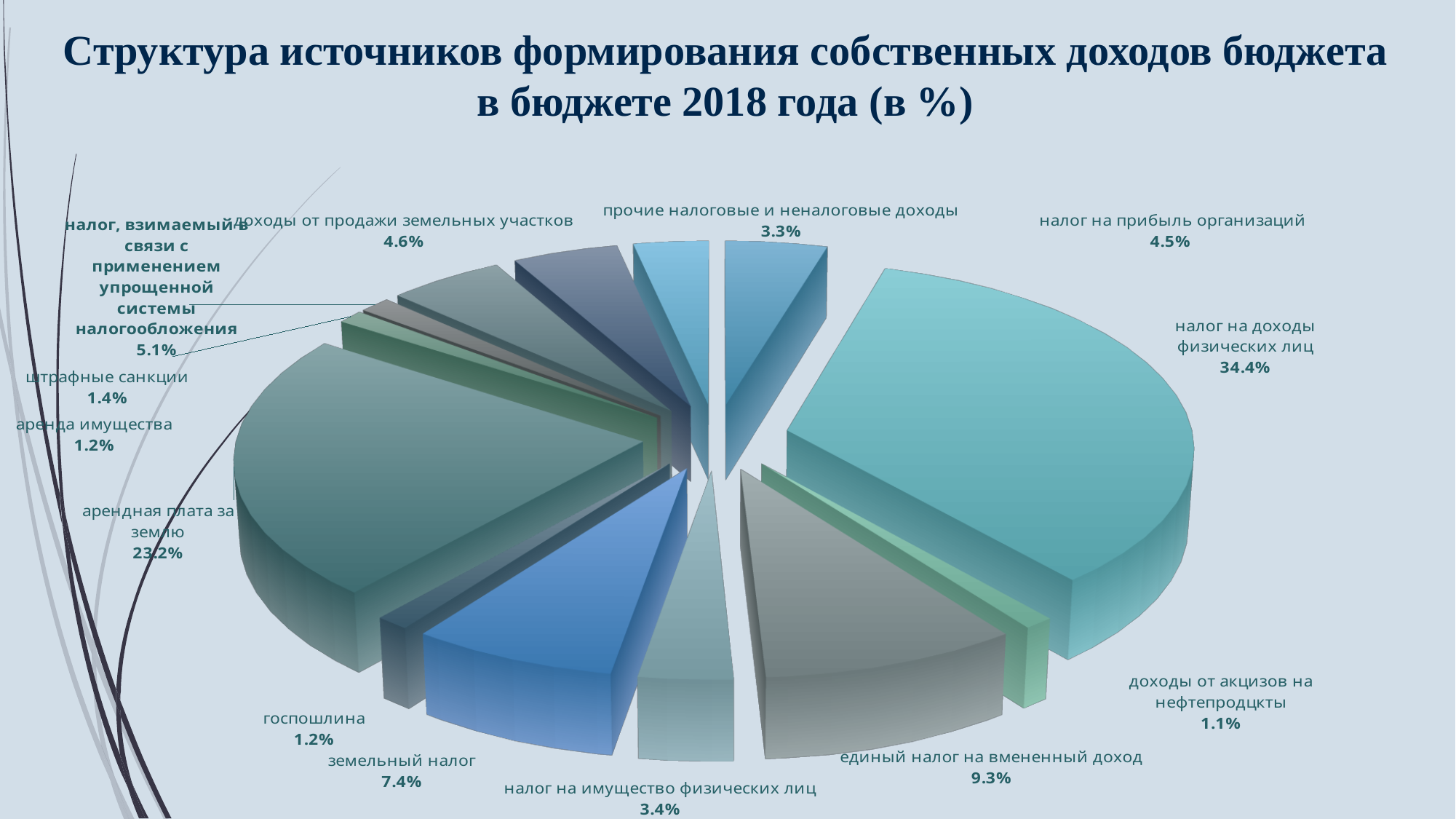
What is the value shown for "земельный налог"? 7.4% What type of chart is shown on the slide? pie chart What is the value shown for "единый налог на вмененный доход"? 9.3% How many categories are shown in the pie chart? 13 What is the title of the chart on the slide? Структура источников формирования собственных доходов бюджета в бюджете 2018 года (в %) What share does "налог на доходы физических лиц" have in the pie chart? 34.4% Which is larger: the share of "земельный налог" or the share of "налог, взимаемый в связи с применением упрощенной системы налогообложения"? земельный налог Which category has the largest share in the pie chart? налог на доходы физических лиц What is the difference between the shares of "налог на доходы физических лиц" and "арендная плата за землю"? 11.2% What is the value shown for "доходы от продажи земельных участков"? 4.6% What share does "арендная плата за землю" have in the pie chart? 23.2% Which category has the smallest share in the pie chart? доходы от акцизов на нефтепродцкты